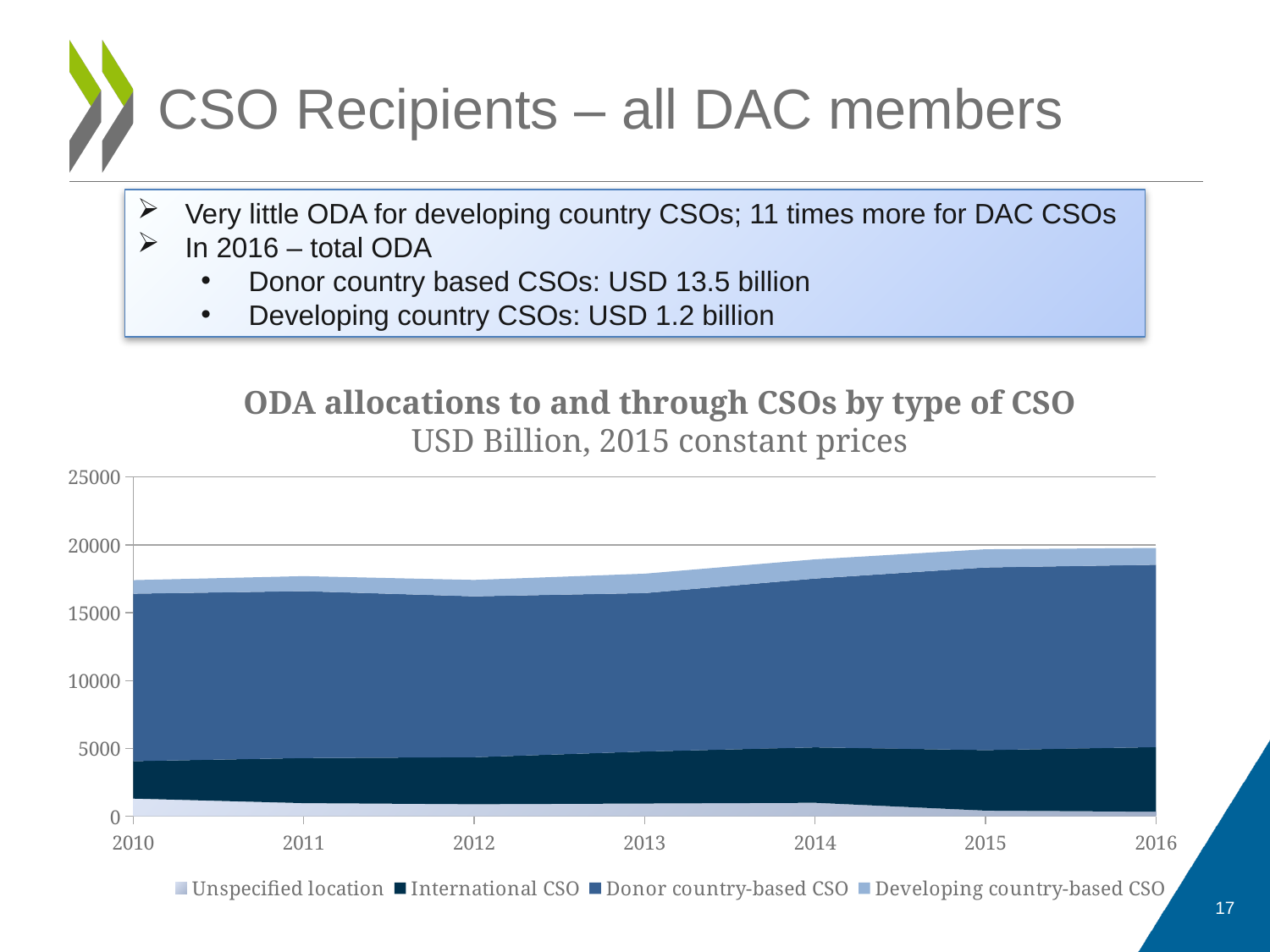
Which year has the larger total stacked value, 2010 or 2016? 2016 Is the total stacked value for 2016 greater or less than 15000? greater How many series does the chart legend list? 4 Is the total stacked value for 2013 greater or less than 20000? less What unit and price basis does the chart subtitle state? USD Billion, 2015 constant prices What is the title of the chart? ODA allocations to and through CSOs by type of CSO What kind of chart is shown on the slide? Stacked area chart Is the total stacked value for 2010 greater or less than 15000? greater How many years are shown along the x axis of the chart? 7 Does the total stacked value generally rise or fall from 2010 to 2016? rise